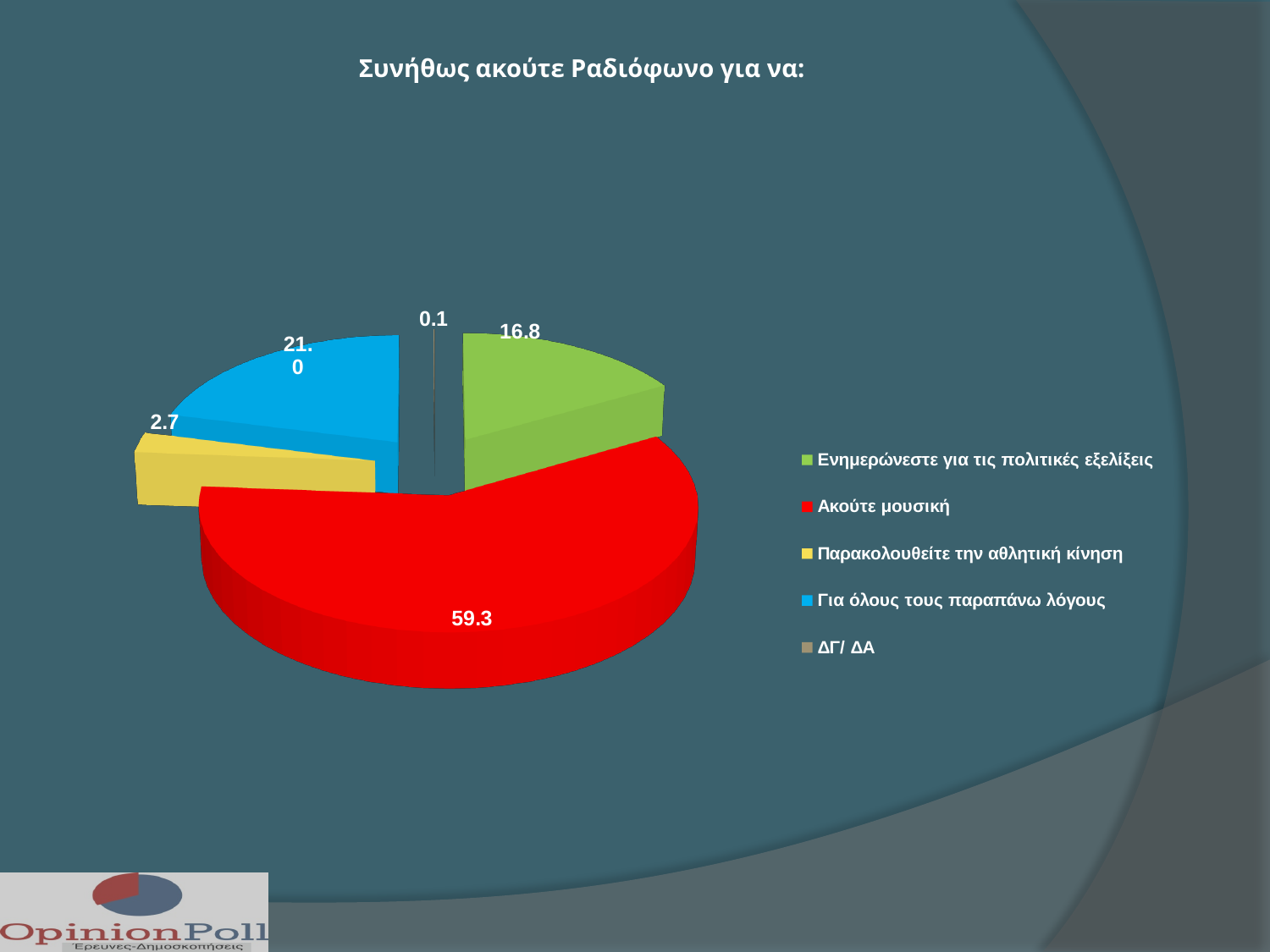
How many categories does the legend list? 5 What is the value for "Παρακολουθείτε την αθλητική κίνηση"? 2.7 What kind of chart is shown on the slide? pie chart What is the value for "Ακούτε μουσική"? 59.3 What is the value for "ΔΓ/ ΔΑ"? 0.1 What is the difference between the values for "Ακούτε μουσική" and "Για όλους τους παραπάνω λόγους"? 38.3 Which is larger: the value for "Ενημερώνεστε για τις πολιτικές εξελίξεις" or the value for "Για όλους τους παραπάνω λόγους"? Για όλους τους παραπάνω λόγους Which category has the smallest slice of the pie? ΔΓ/ ΔΑ What is the value for "Για όλους τους παραπάνω λόγους"? 21.0 What is the title of the chart? Συνήθως ακούτε Ραδιόφωνο για να: What is the value for "Ενημερώνεστε για τις πολιτικές εξελίξεις"? 16.8 Which category has the largest slice of the pie? Ακούτε μουσική